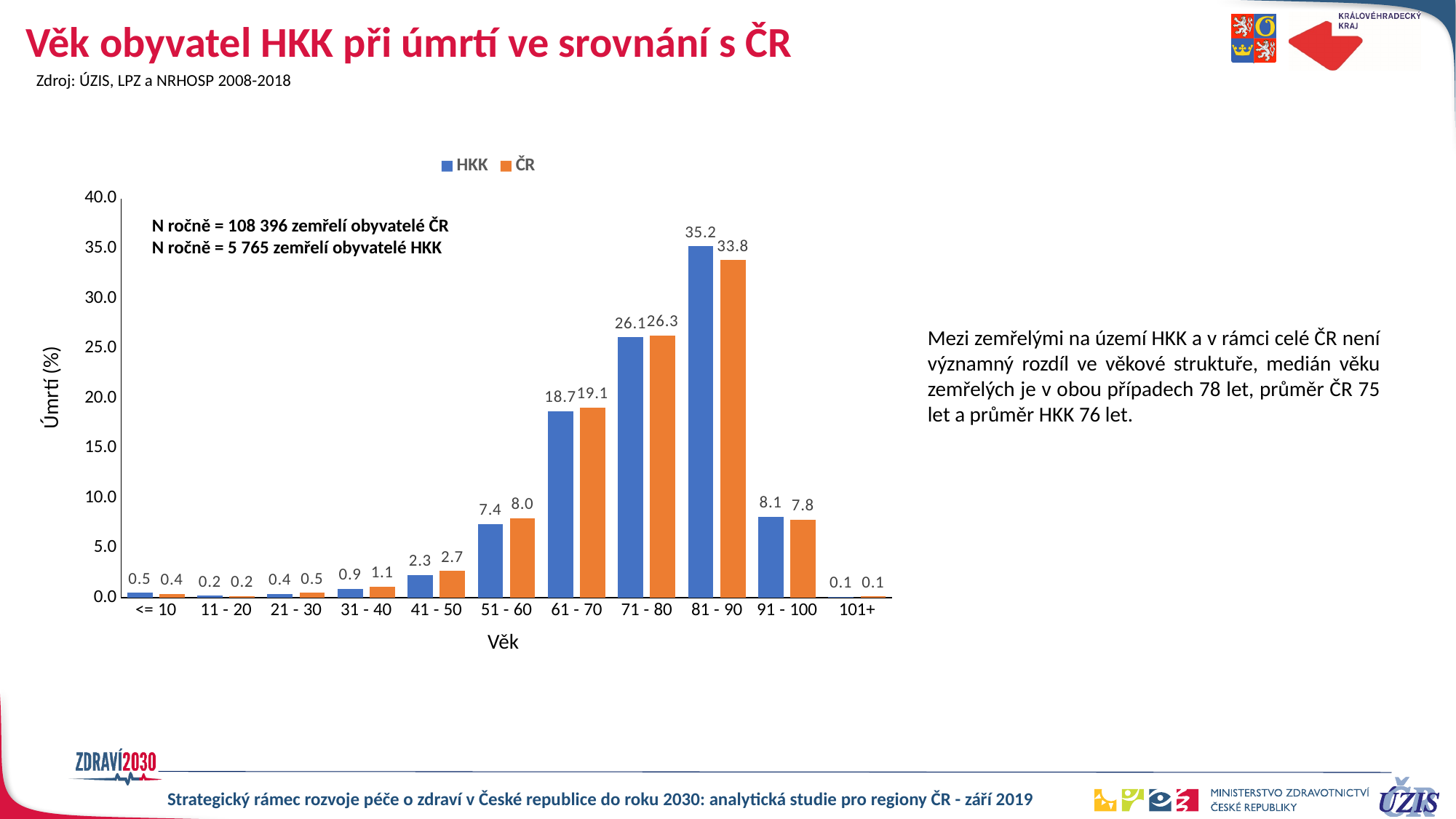
Which is larger for the 91 - 100 age group, the HKK value or the ČR value? HKK What is the HKK value for the 81 - 90 age group? 35.2 What is the label of the y axis? Úmrtí (%) Is the ČR value for the 71 - 80 age group greater or less than 25.0? greater How many age groups are shown on the x axis? 11 Which age group has the highest ČR value? 81 - 90 What kind of chart is shown on the slide? bar chart What is the difference between the HKK and ČR values for the 81 - 90 age group? 1.4 What is the HKK value for the 41 - 50 age group? 2.3 What is the difference between the HKK values for the 71 - 80 and 61 - 70 age groups? 7.4 What is the ČR value for the 61 - 70 age group? 19.1 How many series does the legend list? 2